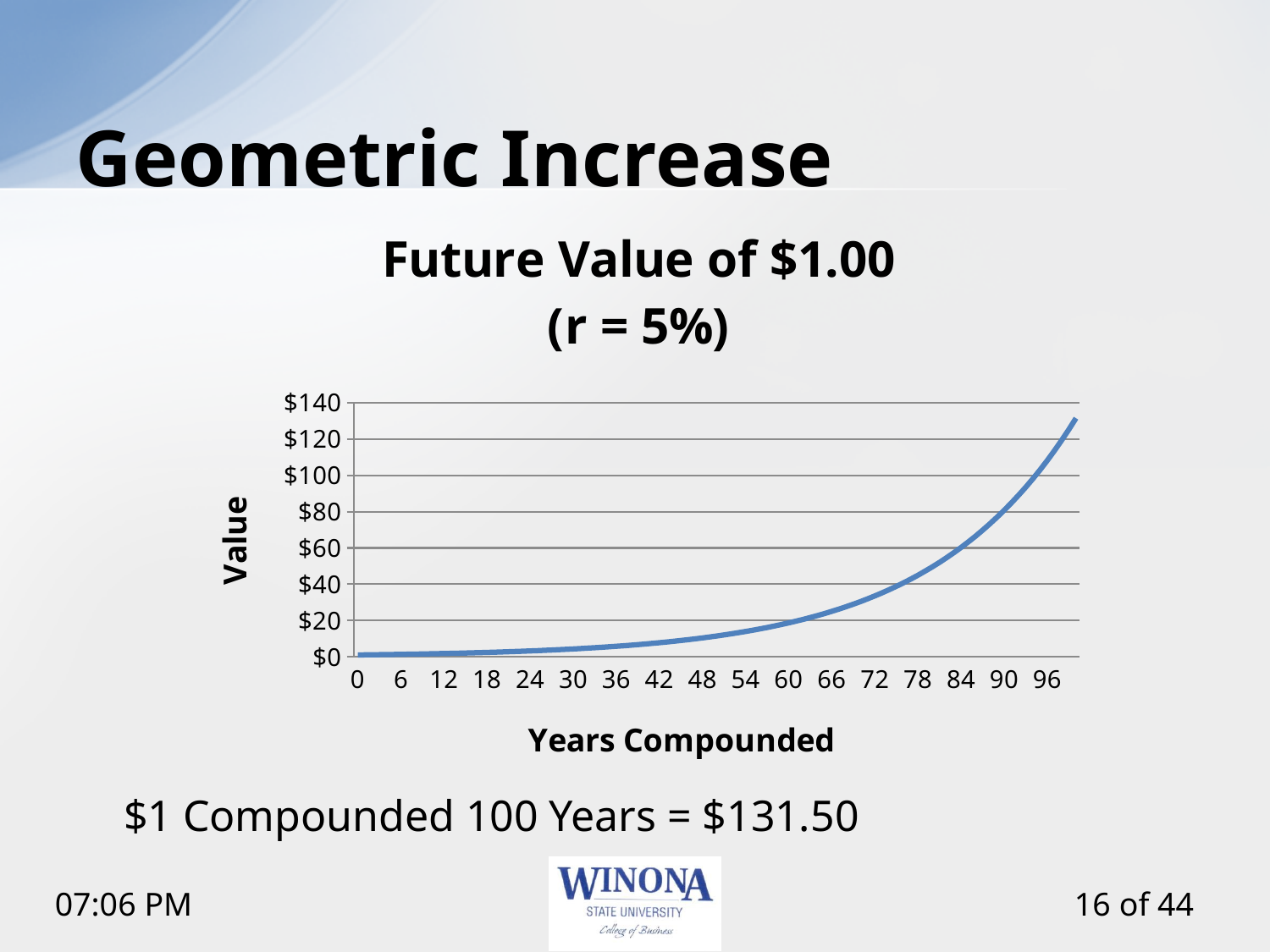
Is the value at 30 years compounded greater or less than $20? less Is the value at 48 years compounded greater or less than $20? less Does the value rise or fall as the years compounded increase? rise What is the label of the x axis of the chart? Years Compounded What kind of chart is shown on the slide? line chart Is the value at 78 years compounded greater or less than $40? greater How many tick labels are shown on the x axis of the chart? 17 What is the title of the chart? Future Value of $1.00 (r = 5%) Which has the larger value, 96 years compounded or 60 years compounded? 96 years compounded According to the slide, what is the value of $1 compounded for 100 years? $131.50